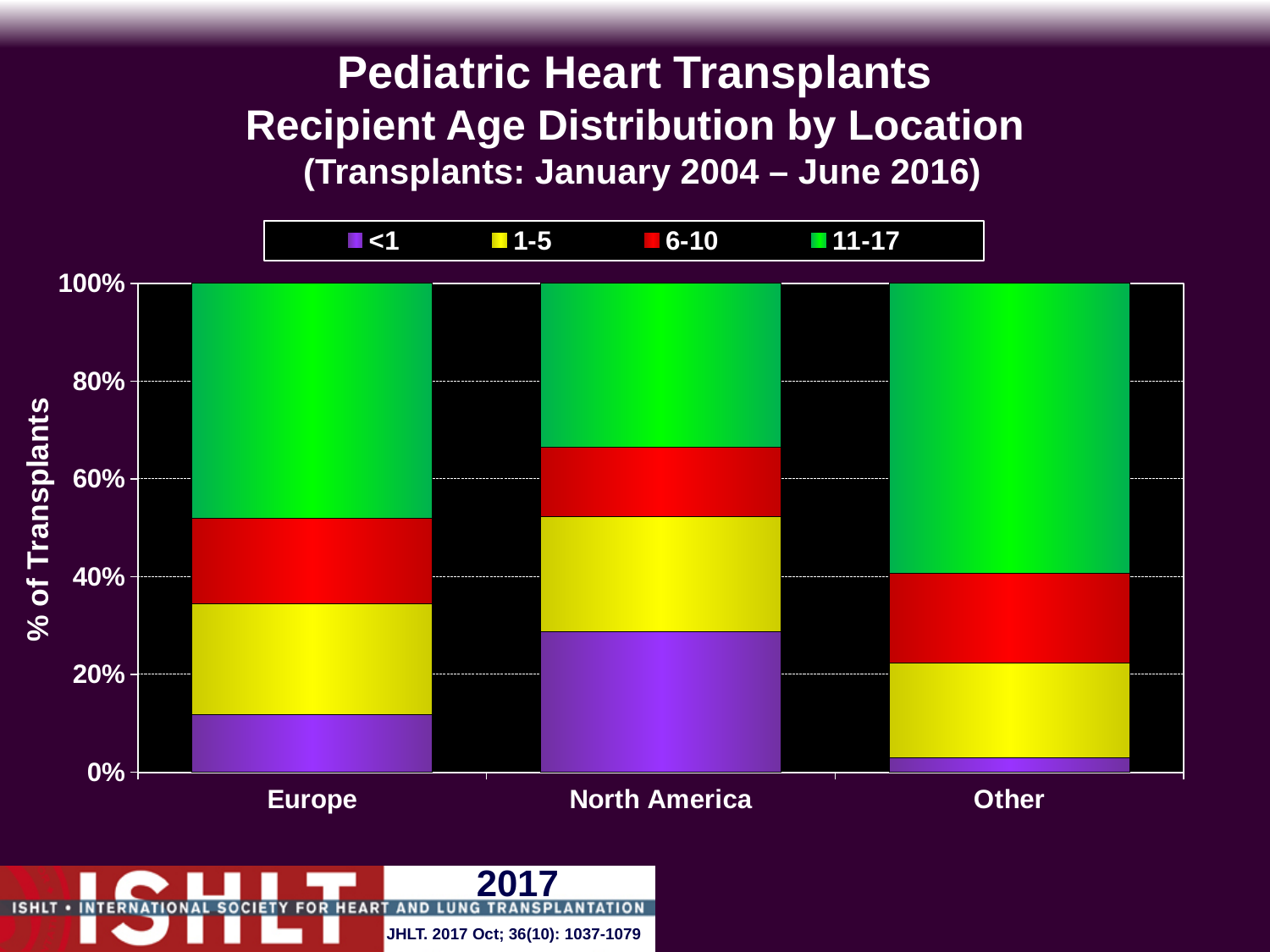
What kind of chart is shown on the slide? Stacked bar chart How many locations are shown on the x axis of the chart? 3 Which location has the largest share of recipients aged 11-17? Other Which location has the smallest share of recipients aged <1? Other Is the share of recipients aged 11-17 in Other greater or less than 40%? greater Is the share of recipients aged <1 in North America greater or less than 20%? greater Which age group is shown in green in the legend? 11-17 How many age groups does the legend list? 4 Which location has a larger share of recipients aged <1, Europe or North America? North America Which location has the largest share of recipients aged <1? North America What is the label on the y axis of the chart? % of Transplants Is the share of recipients aged <1 in Other greater or less than 20%? less